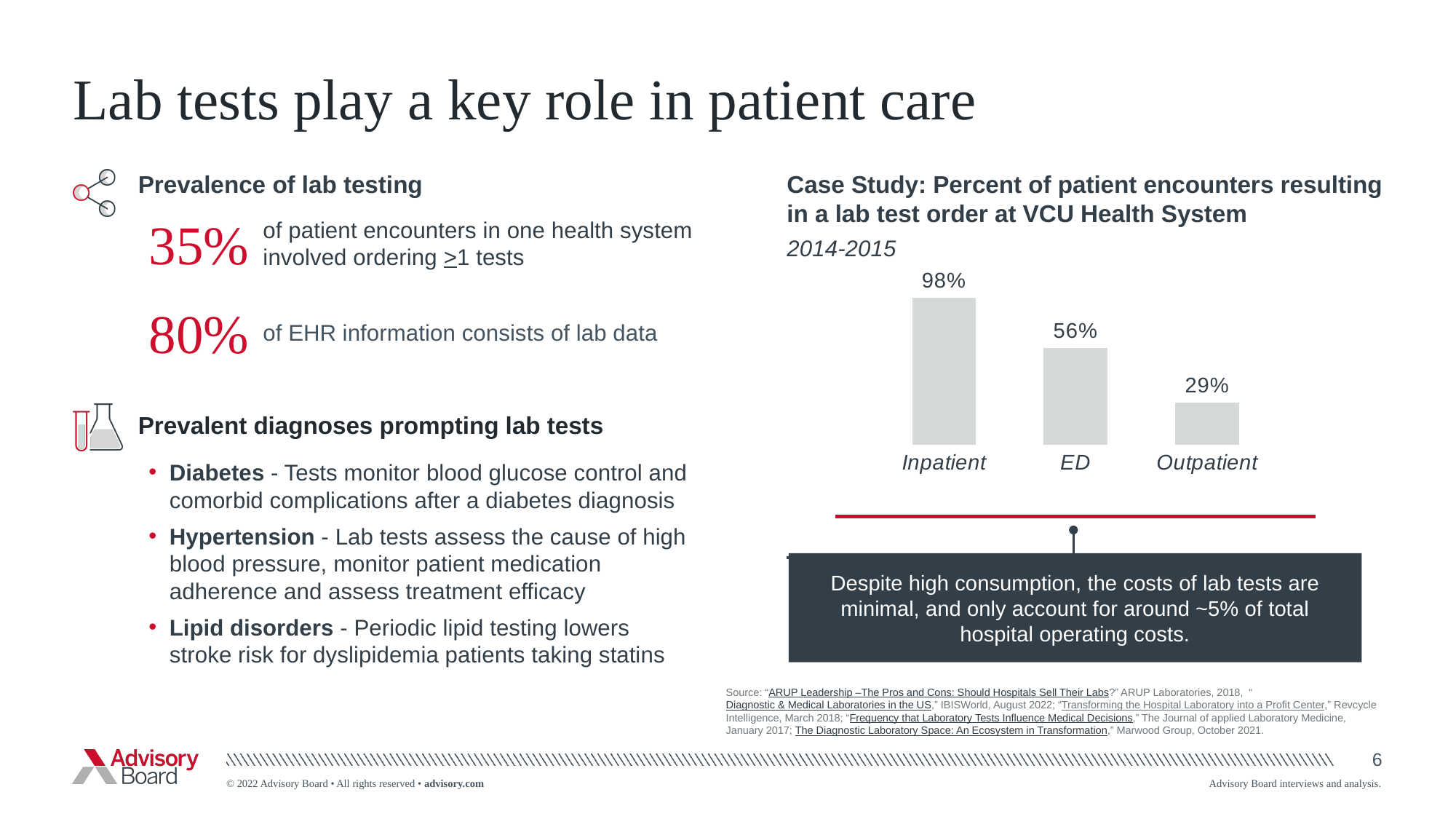
What is the difference between the ED and Outpatient percentages? 27% What kind of chart is used to show the percent of patient encounters resulting in a lab test order? Bar chart What time period does the chart cover, as shown in its subtitle? 2014-2015 Which setting has the highest percent of encounters resulting in a lab test order? Inpatient What is the difference between the Inpatient and Outpatient percentages? 69% How many settings (categories) are shown in the chart? 3 Do the values rise or fall from Inpatient to Outpatient along the x axis? Fall What percent of ED encounters resulted in a lab test order? 56% Which setting has the lowest percent of encounters resulting in a lab test order? Outpatient What percent of Outpatient encounters resulted in a lab test order? 29% Which is larger, the value for ED or the value for Outpatient? ED What percent of Inpatient encounters resulted in a lab test order? 98%